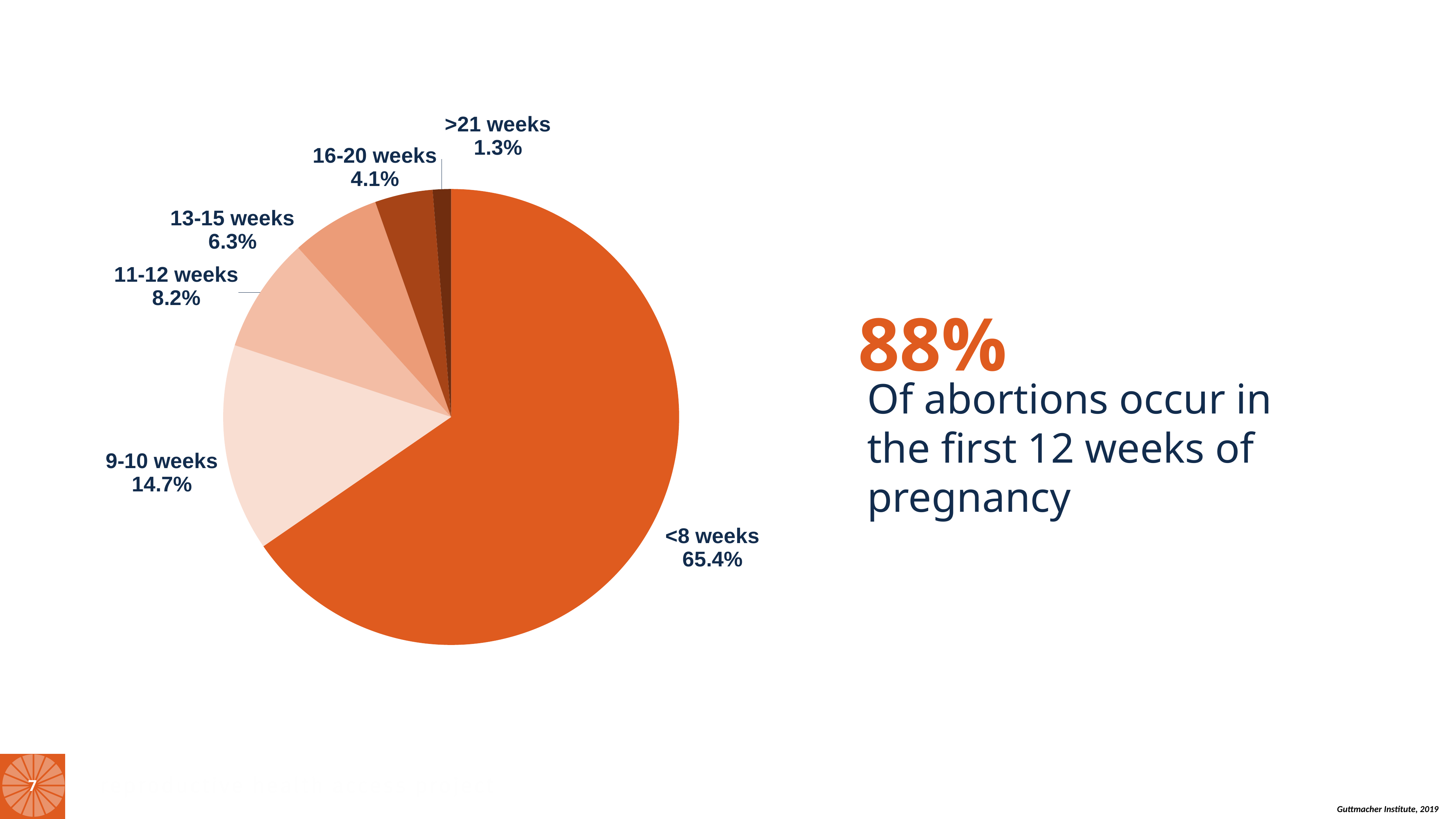
What is the difference in percentage points between the 9-10 weeks and 11-12 weeks slices? 6.5 What source is cited at the bottom of the slide? Guttmacher Institute, 2019 What percentage of abortions occur at 16-20 weeks? 4.1% What is the combined share of the 13-15 weeks and 16-20 weeks slices? 10.4% Which slice is larger: 13-15 weeks or 16-20 weeks? 13-15 weeks How many slices does the pie chart have? 6 What percentage of abortions occur at <8 weeks? 65.4% Which gestational category has the smallest share of the pie? >21 weeks What percentage of abortions occur at >21 weeks? 1.3% What kind of chart is shown on the slide? Pie chart What percentage of abortions occur at 9-10 weeks? 14.7% Which gestational category has the largest share of the pie? <8 weeks